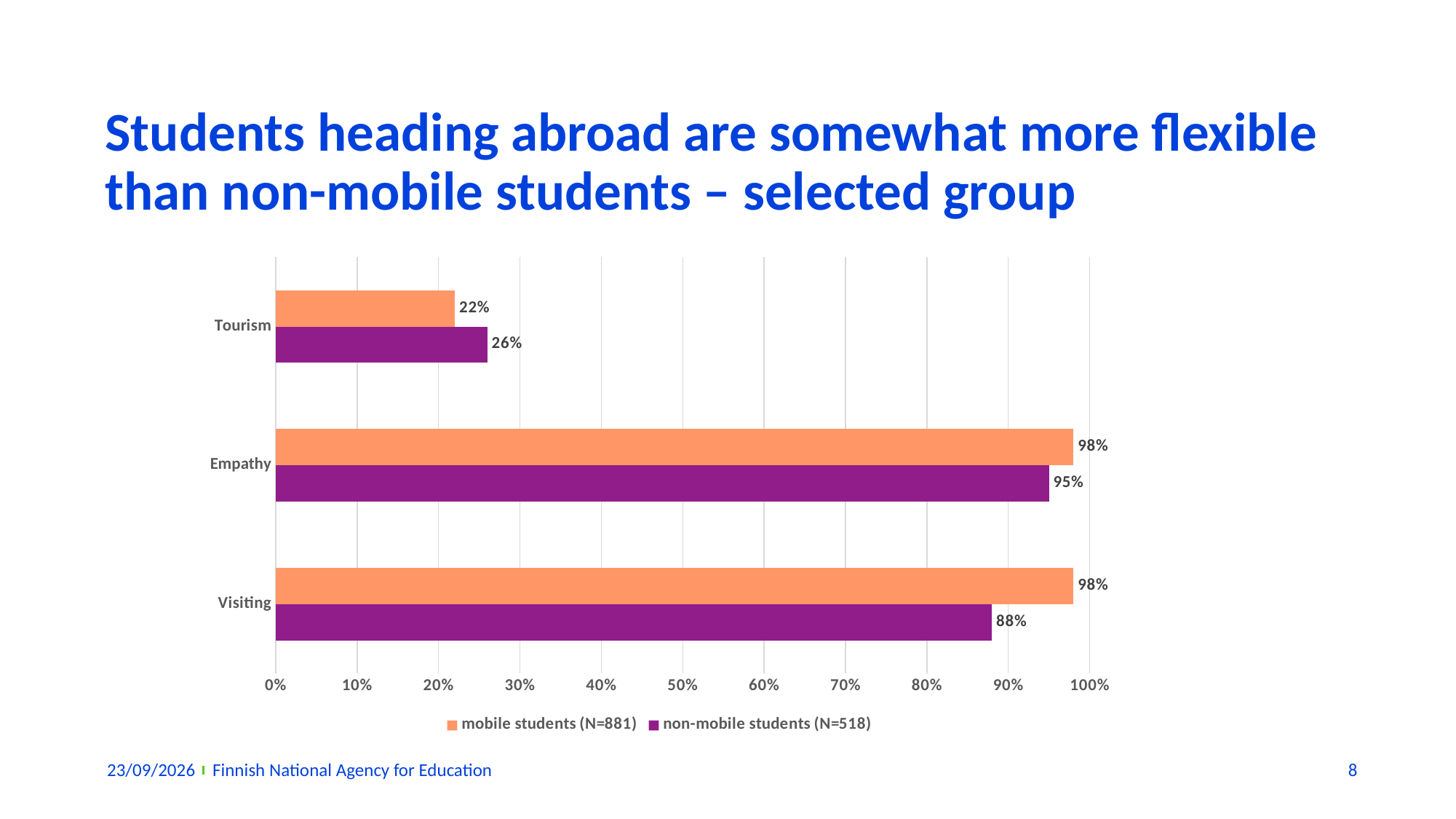
What is the value for non-mobile students (N=518) for Empathy? 95% What is the value for mobile students (N=881) for Tourism? 22% What is the difference between non-mobile students and mobile students for Tourism? 4% What is the value for non-mobile students (N=518) for Tourism? 26% What kind of chart is shown on the slide? bar chart How many series does the legend list? 2 What is the difference between mobile students and non-mobile students for Visiting? 10% Which category has the highest value for non-mobile students (N=518)? Empathy How many categories are shown on the chart? 3 For Tourism, which series has the larger value: mobile students (N=881) or non-mobile students (N=518)? non-mobile students (N=518) Which category has the lowest value for mobile students (N=881)? Tourism What is the value for non-mobile students (N=518) for Visiting? 88%